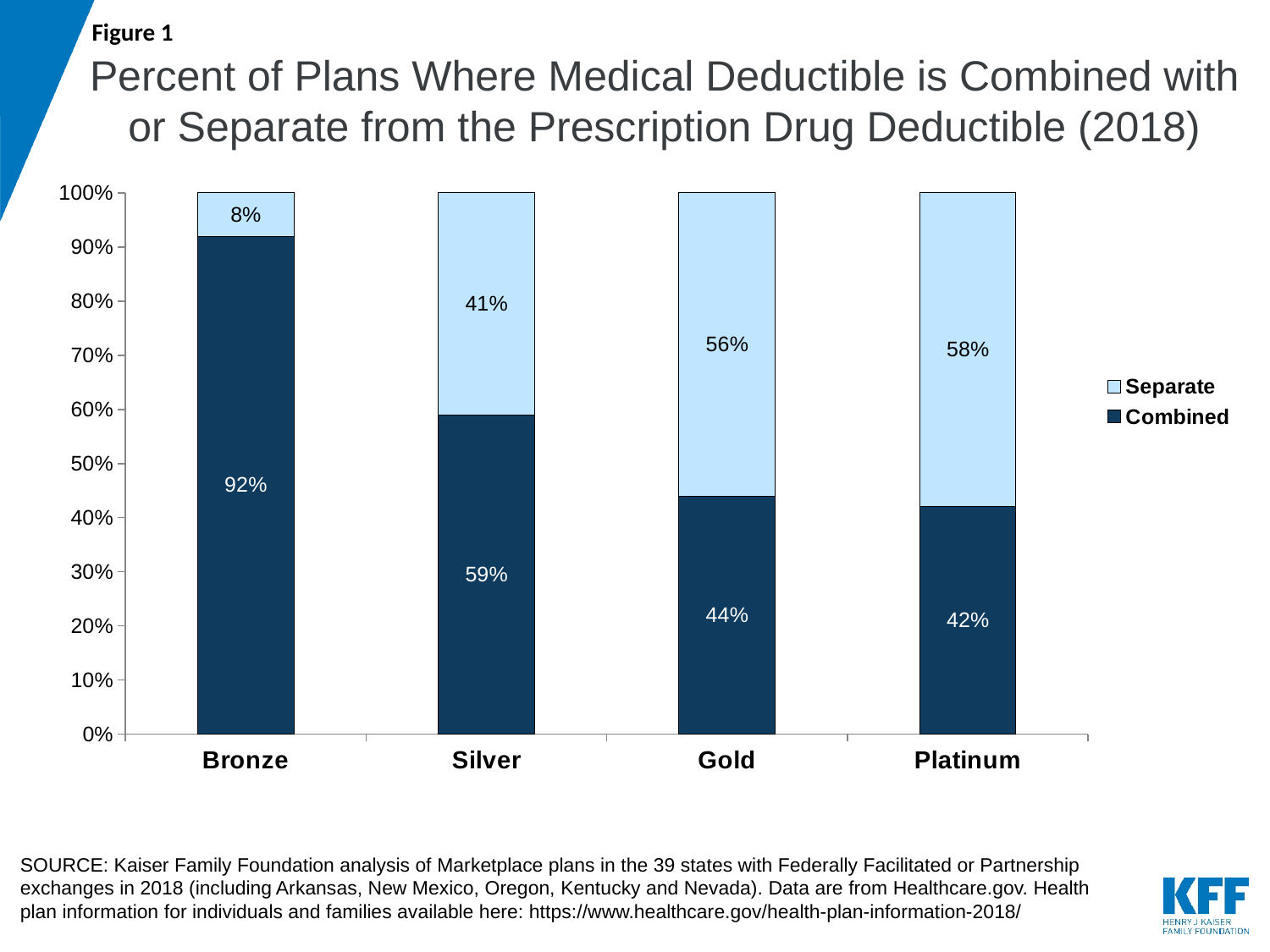
How many metal levels are shown on the x axis? 4 Which metal level has the lowest percent of plans with a Separate deductible? Bronze What percent of Silver plans have a Separate deductible? 41% How many series does the legend list? 2 Which is larger: the Separate share for Gold plans or the Separate share for Silver plans? Gold What percent of Gold plans have a Combined deductible? 44% What kind of chart is shown on the slide? Stacked bar chart Is the Combined value for Platinum plans greater or less than 50%? less What percent of Bronze plans have a Combined deductible? 92% What percent of Platinum plans have a Separate deductible? 58% Which metal level has the highest percent of plans with a Combined deductible? Bronze What is the difference between the Combined percentages for Bronze and Silver plans? 33%